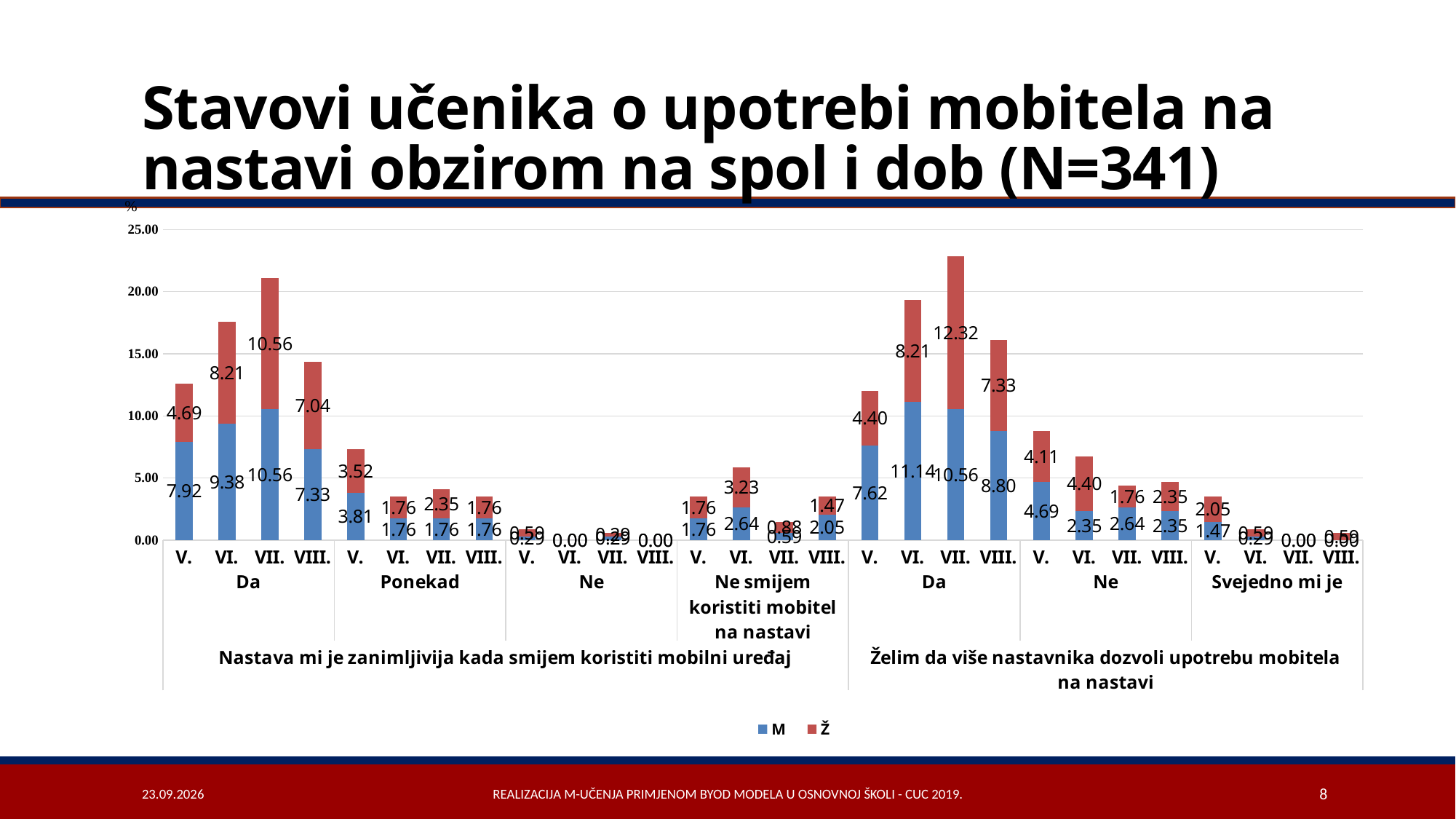
What is the total of the stacked bar for grade V. under 'Da' for 'Nastava mi je zanimljivija kada smijem koristiti mobilni uređaj'? 12.61 What is the Ž value for grade VI. under 'Ne smijem koristiti mobitel na nastavi'? 3.23 What are the two series named in the legend? M and Ž What kind of chart is shown on the slide? Stacked bar chart What is the M value for grade VI. under 'Da' for 'Želim da više nastavnika dozvoli upotrebu mobitela na nastavi'? 11.14 What is the Ž value for grade VII. under 'Da' for 'Želim da više nastavnika dozvoli upotrebu mobitela na nastavi'? 12.32 How many series does the legend list? 2 What is the M value for grade VII. under 'Da' for 'Nastava mi je zanimljivija kada smijem koristiti mobilni uređaj'? 10.56 Is the total stacked bar for grade VII. under 'Da' for 'Želim da više nastavnika dozvoli upotrebu mobitela na nastavi' greater or less than 20.00? greater What is the difference between the M values for grade VI. and grade V. under 'Da' for 'Želim da više nastavnika dozvoli upotrebu mobitela na nastavi'? 3.52 What is the total of the stacked bar for grade VII. under 'Da' for 'Želim da više nastavnika dozvoli upotrebu mobitela na nastavi'? 22.88 Which is larger: the M value for grade V. under 'Ponekad' or the M value for grade V. under 'Ne smijem koristiti mobitel na nastavi'? Grade V. under 'Ponekad' (3.81)